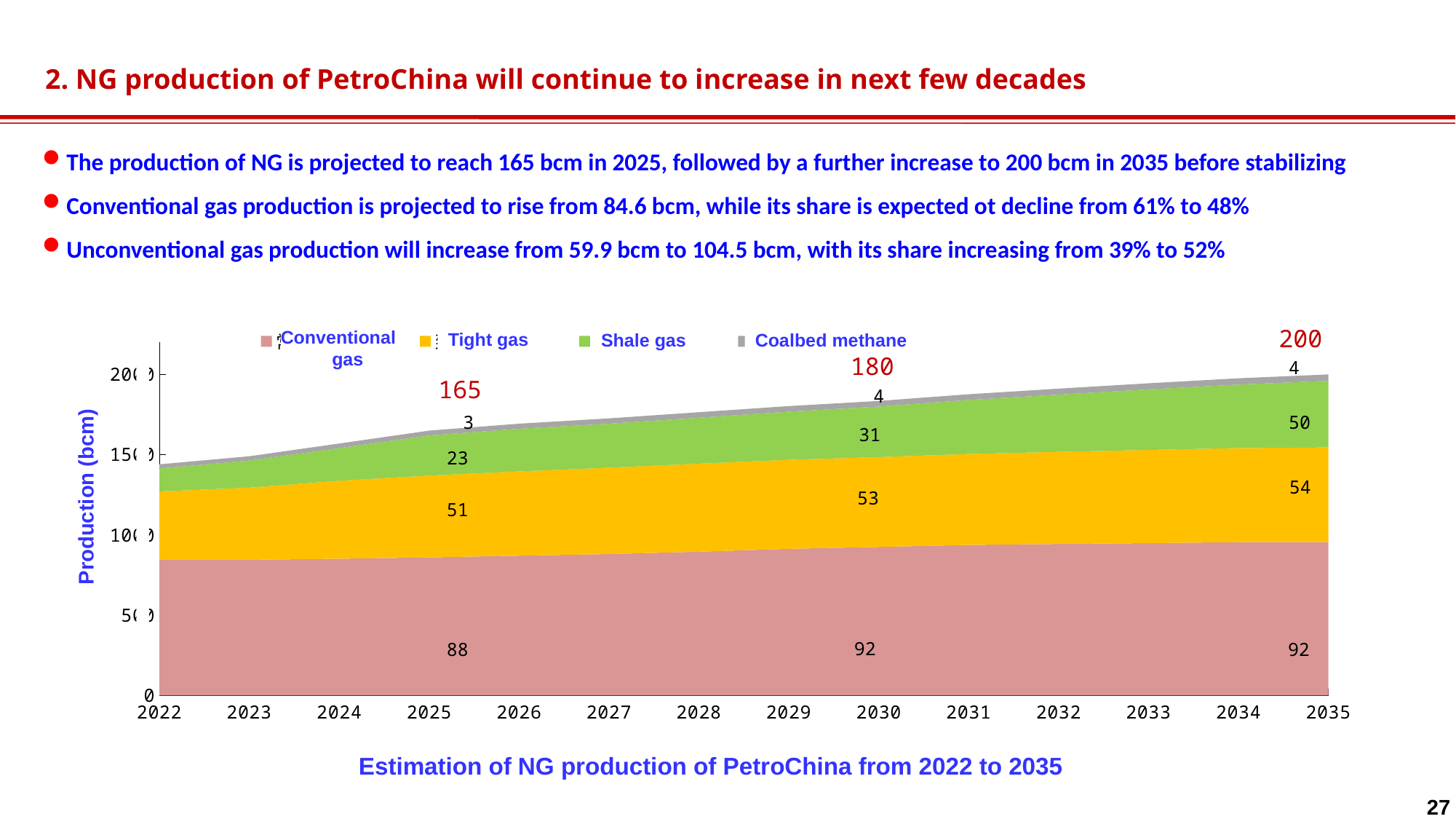
In 2035, is the labelled Tight gas value larger or smaller than the labelled Shale gas value? larger What kind of chart is shown on the slide? stacked area chart Which series has the largest labelled value in 2035? Conventional gas How many series does the legend list? 4 Does total NG production rise or fall from 2022 to 2035? rise What is the Coalbed methane value labelled for 2025? 3 Which series has the smallest labelled value in 2030? Coalbed methane What is the Shale gas production value labelled for 2035? 50 What total NG production is labelled for 2030? 180 What is the Conventional gas production value labelled for 2025? 88 What is the Tight gas production value labelled for 2030? 53 By how much does the labelled Shale gas value increase from 2025 to 2035? 27